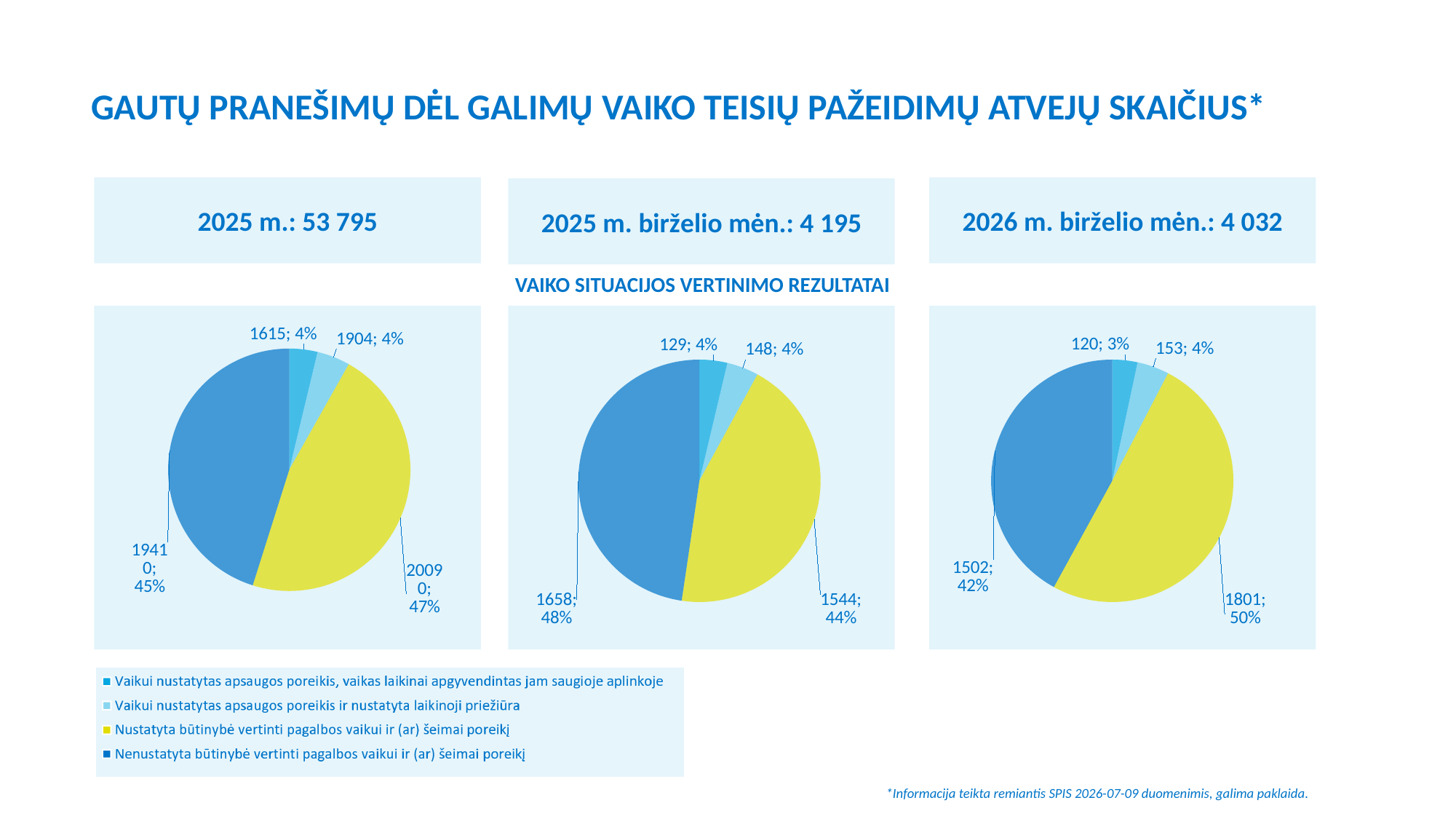
In the right pie chart (2026 m. birželio mėn.), which is larger: 'Nustatyta būtinybė vertinti pagalbos vaikui ir (ar) šeimai poreikį' or 'Nenustatyta būtinybė vertinti pagalbos vaikui ir (ar) šeimai poreikį'? Nustatyta būtinybė vertinti pagalbos vaikui ir (ar) šeimai poreikį What is the total number of reports shown for 2026 m. birželio mėn.? 4 032 In the middle pie chart (2025 m. birželio mėn.), what is the value for 'Nenustatyta būtinybė vertinti pagalbos vaikui ir (ar) šeimai poreikį'? 1658; 48% In the right pie chart (2026 m. birželio mėn.), what share does 'Vaikui nustatytas apsaugos poreikis, vaikas laikinai apgyvendintas jam saugioje aplinkoje' have? 3% In the middle pie chart (2025 m. birželio mėn.), what is the difference between the values for 'Nenustatyta būtinybė vertinti pagalbos vaikui ir (ar) šeimai poreikį' and 'Nustatyta būtinybė vertinti pagalbos vaikui ir (ar) šeimai poreikį'? 114 What kind of charts are shown on the slide? Pie charts In the left pie chart (2025 m.), what share does 'Nustatyta būtinybė vertinti pagalbos vaikui ir (ar) šeimai poreikį' have? 47% How many pie charts are on the slide? 3 In the right pie chart (2026 m. birželio mėn.), what is the value for 'Nustatyta būtinybė vertinti pagalbos vaikui ir (ar) šeimai poreikį'? 1801; 50% How many entries does the legend list? 4 In the right pie chart (2026 m. birželio mėn.), which category has the smallest slice? Vaikui nustatytas apsaugos poreikis, vaikas laikinai apgyvendintas jam saugioje aplinkoje In the middle pie chart (2025 m. birželio mėn.), which category has the largest slice? Nenustatyta būtinybė vertinti pagalbos vaikui ir (ar) šeimai poreikį